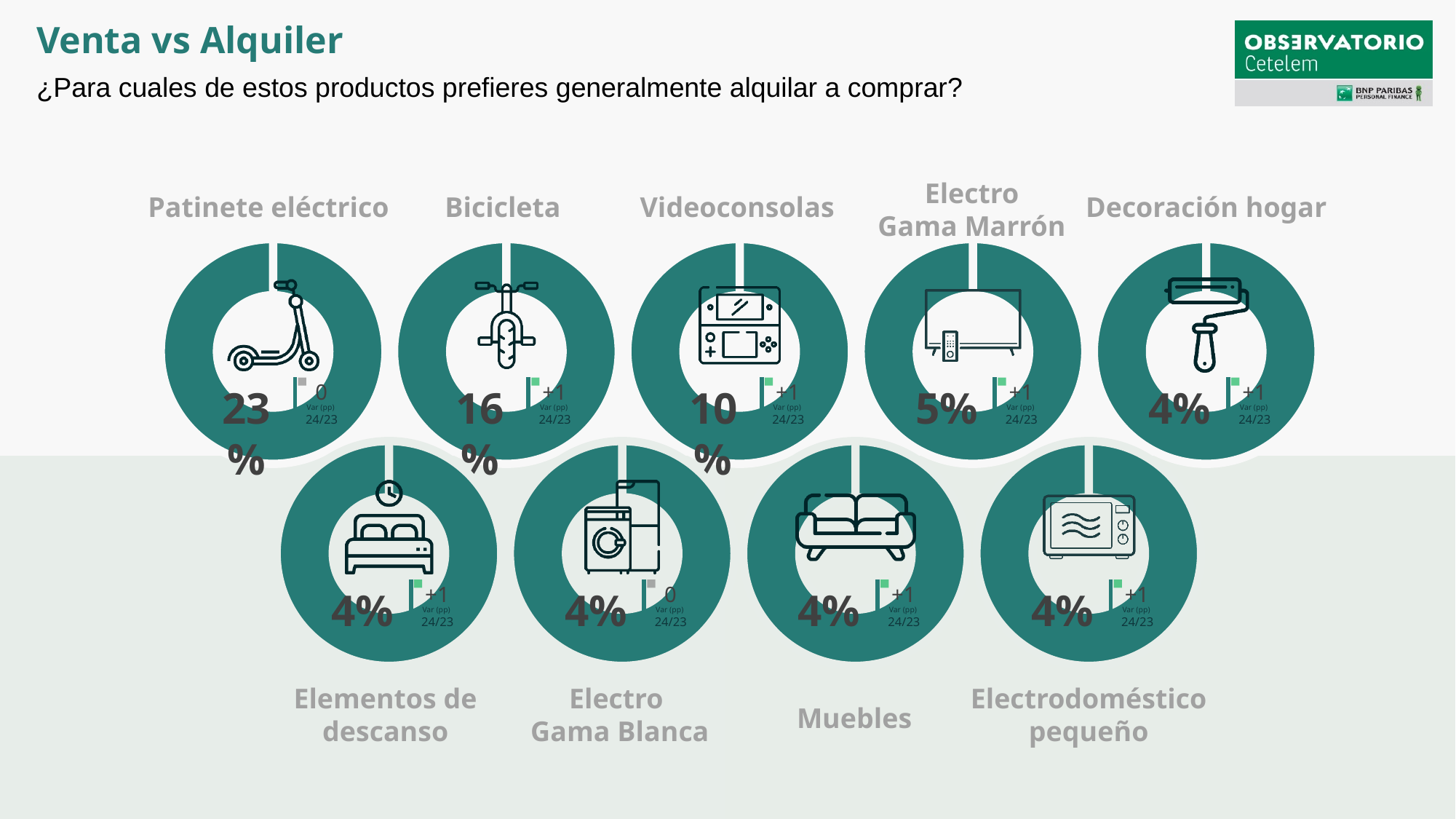
What is the Var (pp) 24/23 value shown for Bicicleta? +1 What percentage is shown for Electro Gama Marrón? 5% What is the difference in percentage points between Patinete eléctrico and Bicicleta? 7 Which product has the highest percentage on the slide? Patinete eléctrico What percentage is shown for Muebles? 4% What kind of chart is used for each product on the slide? Donut chart What is the Var (pp) 24/23 value shown for Electro Gama Blanca? 0 What percentage is shown for Patinete eléctrico? 23% Which has a higher percentage, Videoconsolas or Electro Gama Marrón? Videoconsolas What percentage is shown for Bicicleta? 16% What percentage is shown for Videoconsolas? 10% How many products (donut charts) are shown on the slide? 9